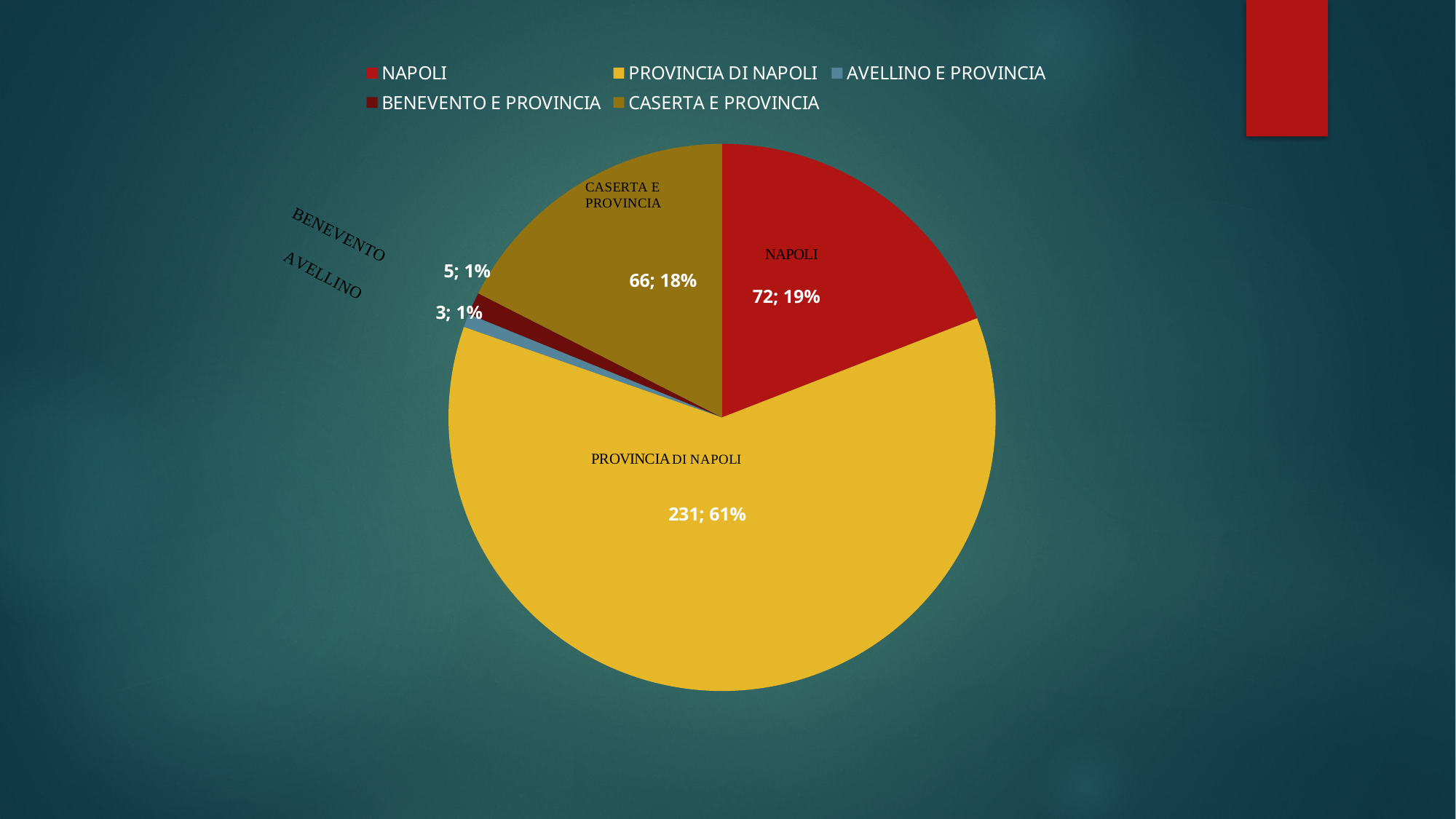
What kind of chart is shown on the slide? pie chart What is the value shown for NAPOLI? 72 Which category has the largest slice? PROVINCIA DI NAPOLI Which is larger, the value for NAPOLI or the value for CASERTA E PROVINCIA? NAPOLI What is the value shown for CASERTA E PROVINCIA? 66 How many slices does the pie chart have? 5 What is the difference between the values for NAPOLI and CASERTA E PROVINCIA? 6 What percentage share does PROVINCIA DI NAPOLI have? 61% How many entries does the legend list? 5 What percentage share does CASERTA E PROVINCIA have? 18% What is the value shown for PROVINCIA DI NAPOLI? 231 Which category has the smallest slice? AVELLINO E PROVINCIA